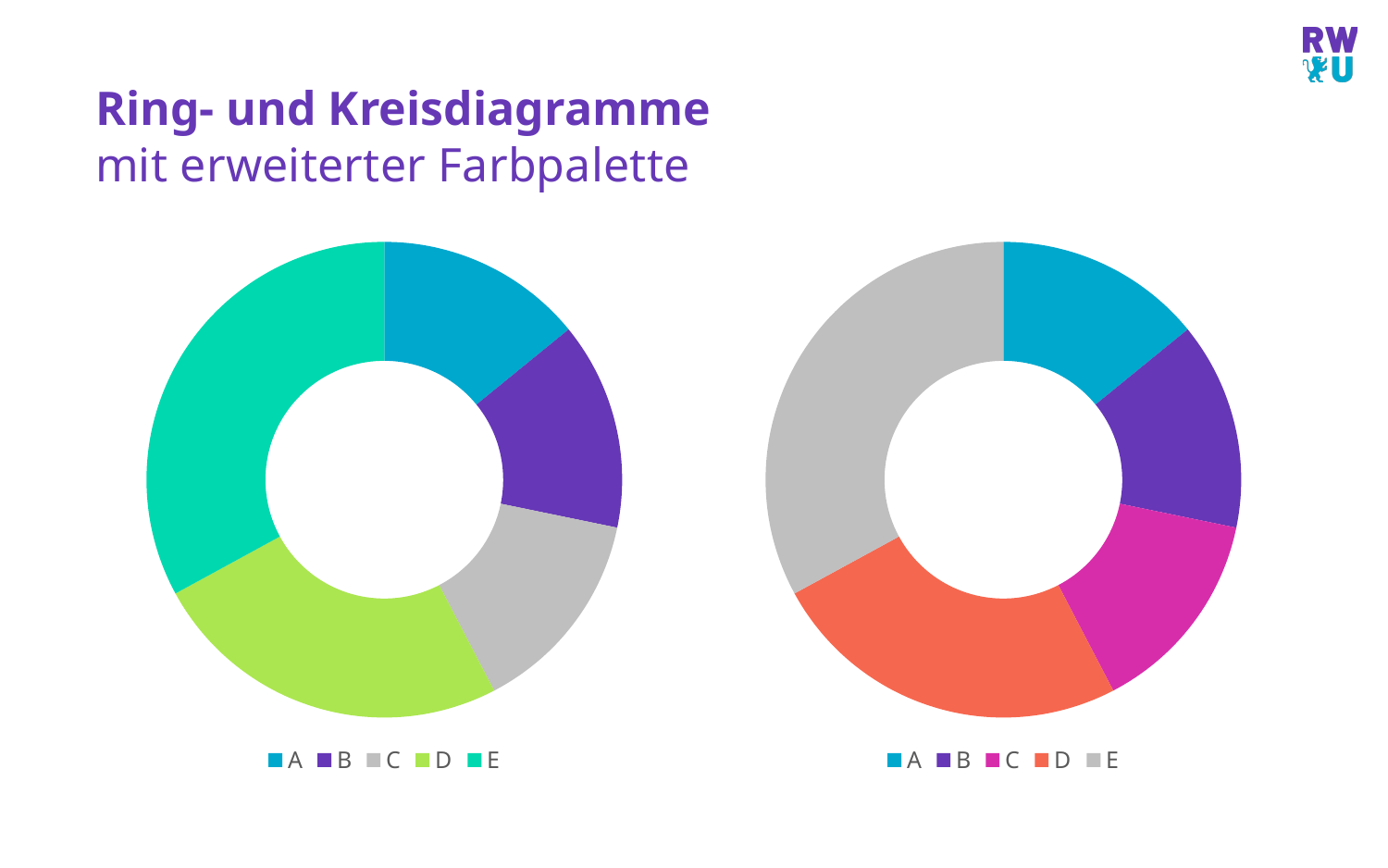
In the right chart, how many entries does the legend list? 5 In the left chart, which category has the largest slice? E What kind of chart is the chart on the right of the slide? doughnut chart In the right chart, which slice is larger, E or B? E In the right chart, which slice is larger, D or C? D What is the title of the slide containing the two charts? Ring- und Kreisdiagramme mit erweiterter Farbpalette What kind of chart is the chart on the left of the slide? doughnut chart In the left chart, which slice is larger, D or A? D In the right chart, which category has the largest slice? E In the right chart, what colour is the slice for category E? grey In the left chart, how many categories does the legend list? 5